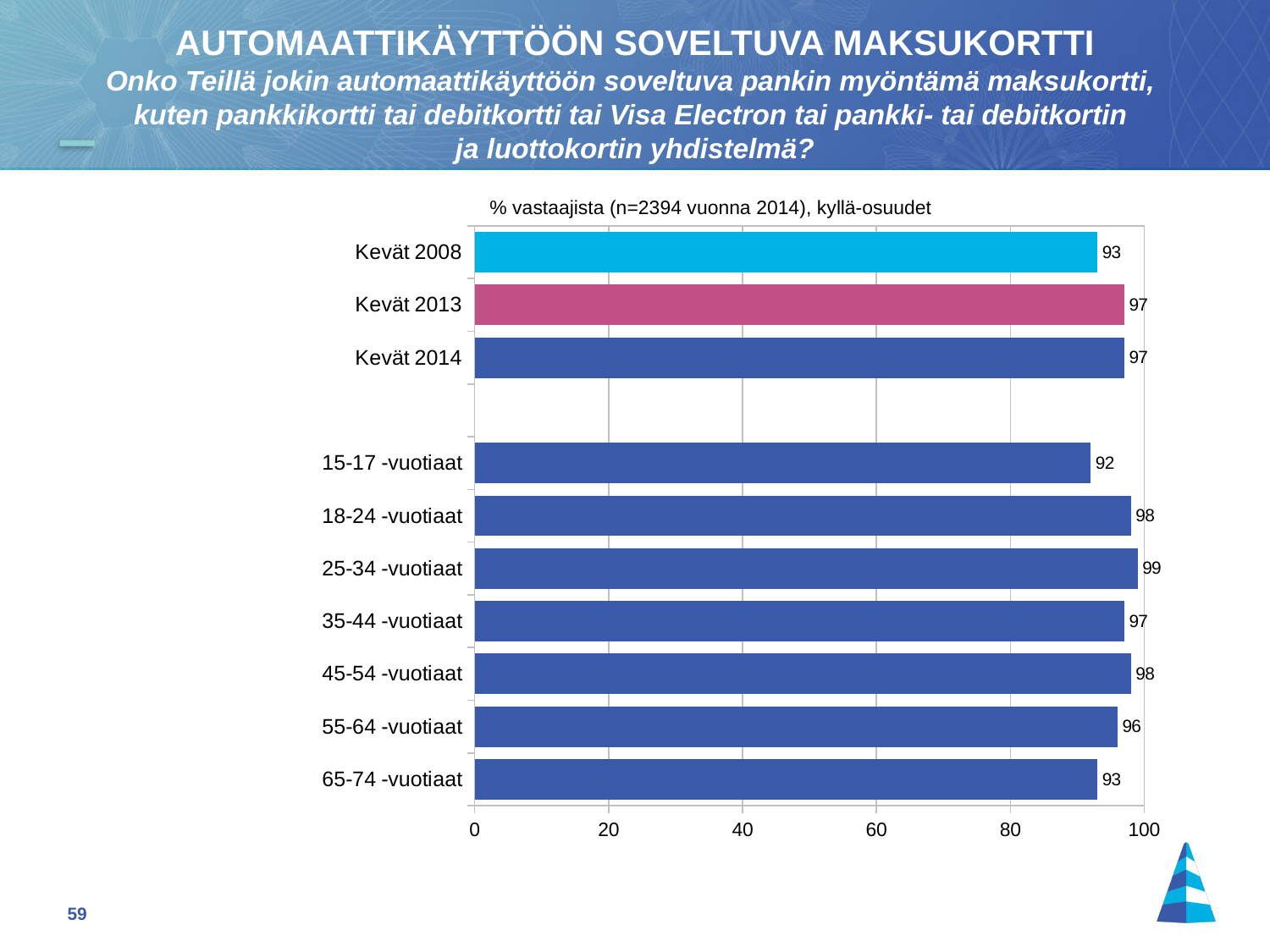
How many bars are plotted in the chart? 10 Which age group has the lowest value? 15-17 -vuotiaat What is the value for 55-64 -vuotiaat? 96 Which is larger, the value for 18-24 -vuotiaat or the value for 65-74 -vuotiaat? 18-24 -vuotiaat What is the difference between the values for 25-34 -vuotiaat and 15-17 -vuotiaat? 7 What is the subtitle text shown above the chart? % vastaajista (n=2394 vuonna 2014), kyllä-osuudet What kind of chart is shown on the slide? bar chart What is the difference between the values for Kevät 2013 and Kevät 2008? 4 What is the value for Kevät 2008? 93 What is the value for 25-34 -vuotiaat? 99 Is the value for 35-44 -vuotiaat greater or less than 80? greater Which age group has the highest value? 25-34 -vuotiaat